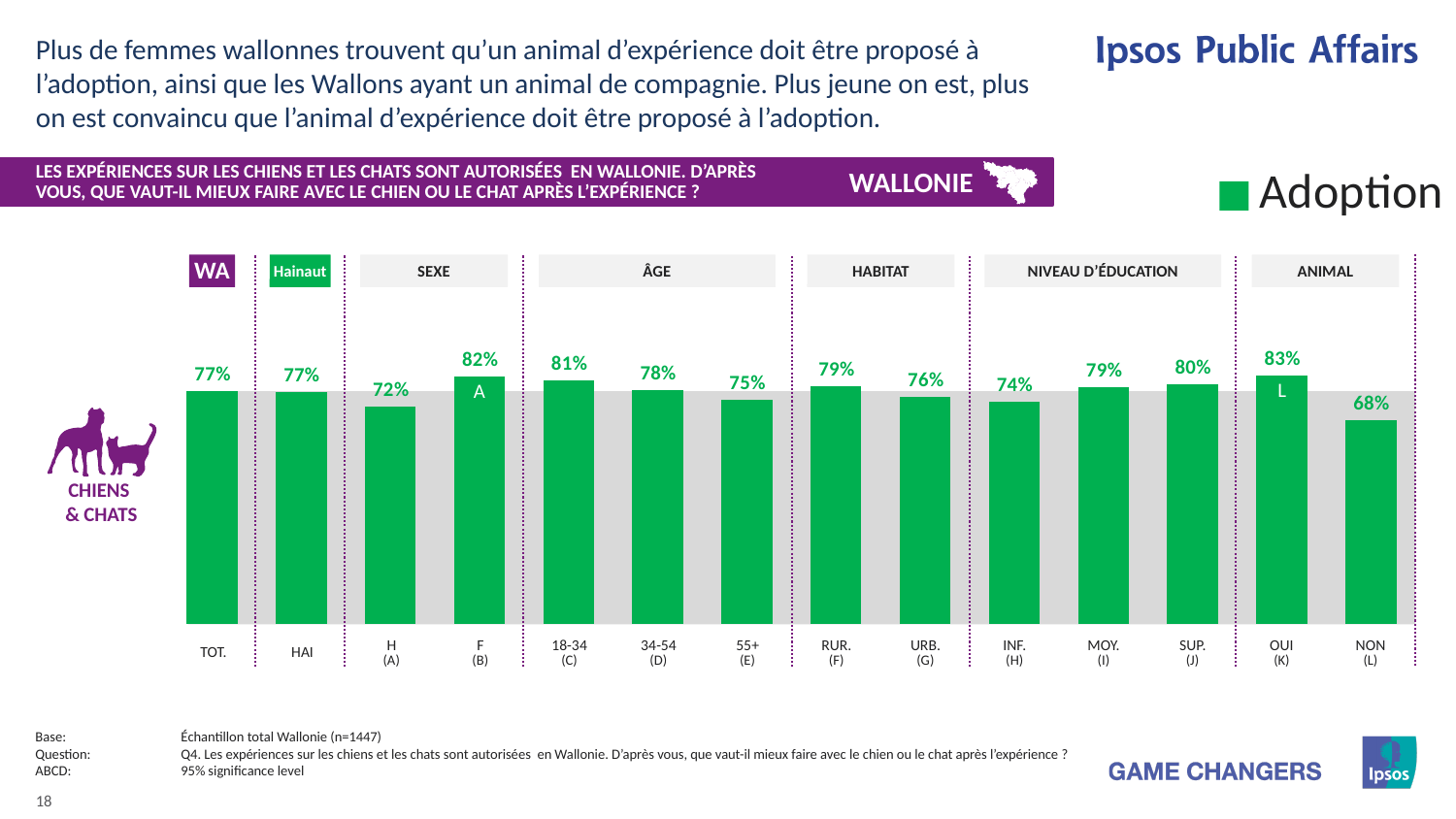
Which is larger, the value for RUR. or the value for URB.? RUR. Do the values rise or fall across the age groups from 18-34 to 55+? Fall What is the value for NON in the ANIMAL group? 68% Which category has the lowest value on the chart? NON (L) What is the value for F (women) in the SEXE group? 82% What is the value for the 18-34 age group? 81% Which category has the highest value on the chart? OUI (K) How many series does the legend list? 1 How many bars are plotted on the chart? 14 What is the value for TOT. (total Wallonie)? 77% What is the difference between the values for F and H in the SEXE group? 10 percentage points What kind of chart is shown on the slide? Bar chart